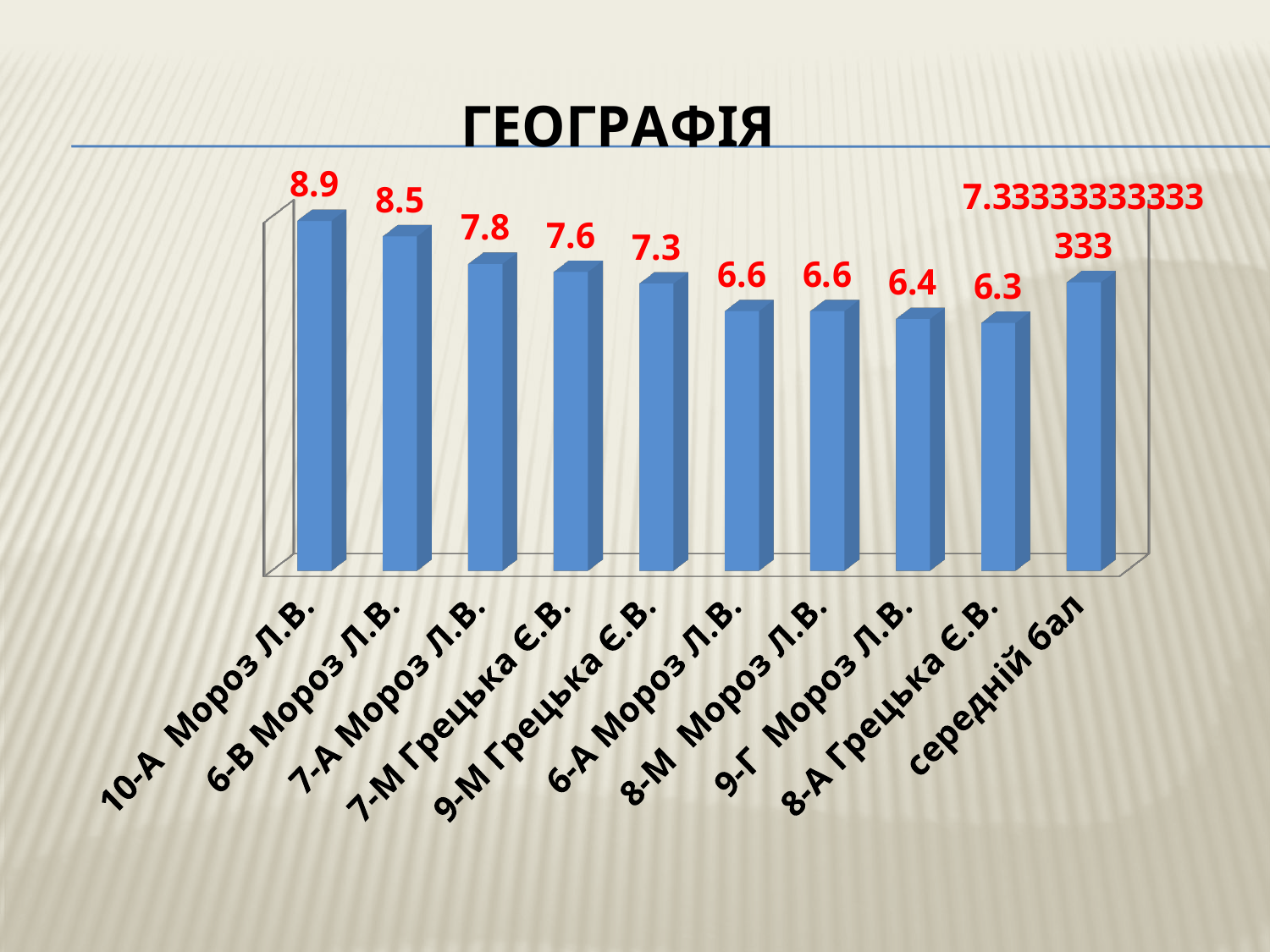
Which is larger, the value for 9-М Грецька Є.В. or the value for 6-А Мороз Л.В.? 9-М Грецька Є.В. What is the difference between the values for 7-А Мороз Л.В. and 8-А Грецька Є.В.? 1.5 What is the title of the chart? ГЕОГРАФІЯ What is the difference between the values for 10-А Мороз Л.В. and 6-В Мороз Л.В.? 0.4 What is the value shown for середній бал? 7.33333333333333 How many categories are shown on the chart? 10 What is the value for 7-М Грецька Є.В.? 7.6 What kind of chart is shown on the slide? bar chart Which category has the lowest value? 8-А Грецька Є.В. What is the value for 9-Г Мороз Л.В.? 6.4 Which category has the highest value? 10-А Мороз Л.В. What is the value for 10-А Мороз Л.В.? 8.9